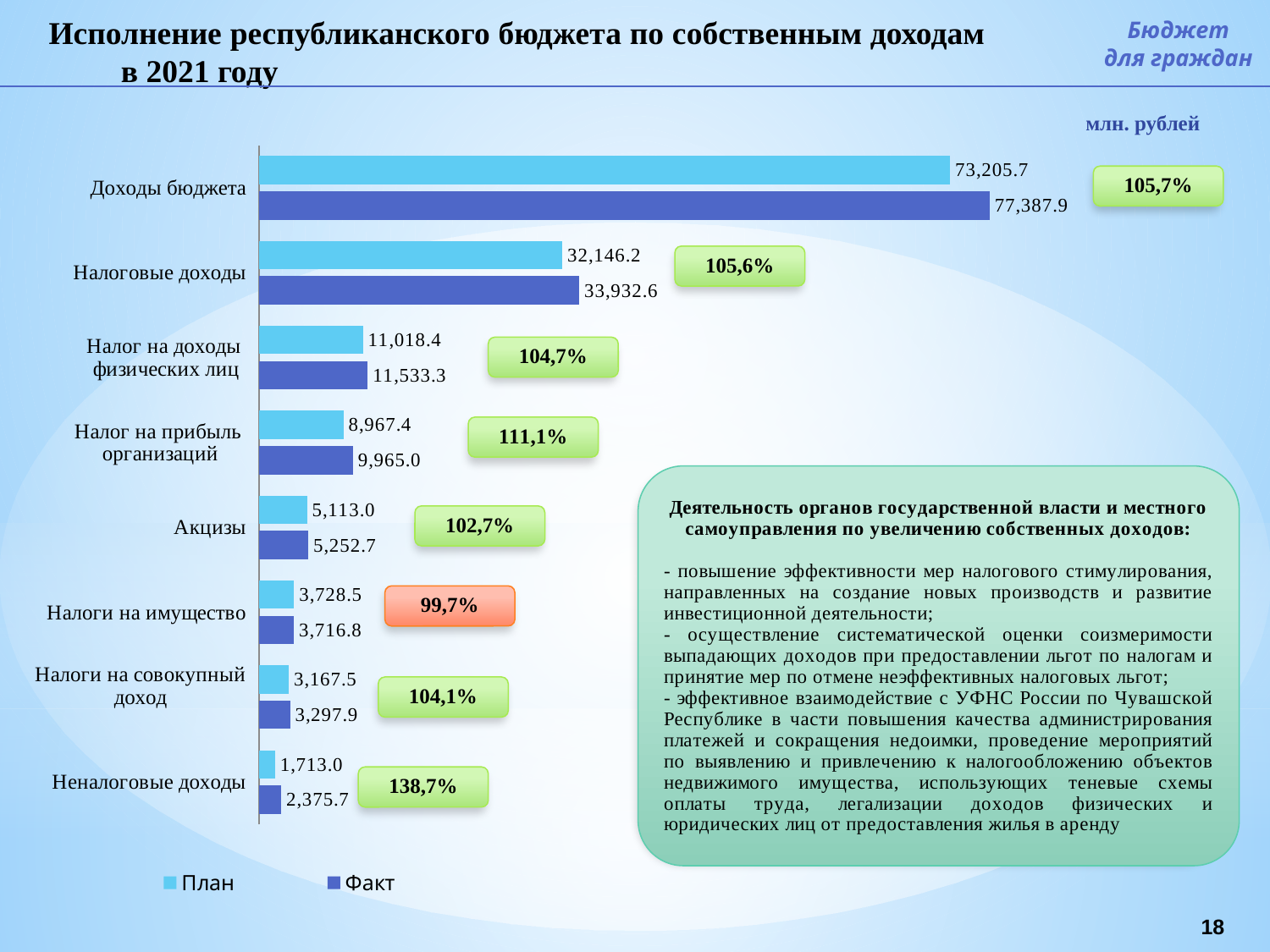
What is the difference between the Факт and План values for Неналоговые доходы? 662.7 What is the difference between the Факт and План values for Доходы бюджета? 4,182.2 What type of chart is shown on the slide? Bar chart How many categories are shown in the chart? 8 Which category has the lowest Факт value? Неналоговые доходы What is the План value for Акцизы? 5,113.0 For Налоги на имущество, which is larger: the План value or the Факт value? План What is the Факт value for Налог на прибыль организаций? 9,965.0 What is the Факт (actual) value for Неналоговые доходы? 2,375.7 How many series does the legend list? 2 What is the План (plan) value for Доходы бюджета? 73,205.7 Which category has the highest План value? Доходы бюджета